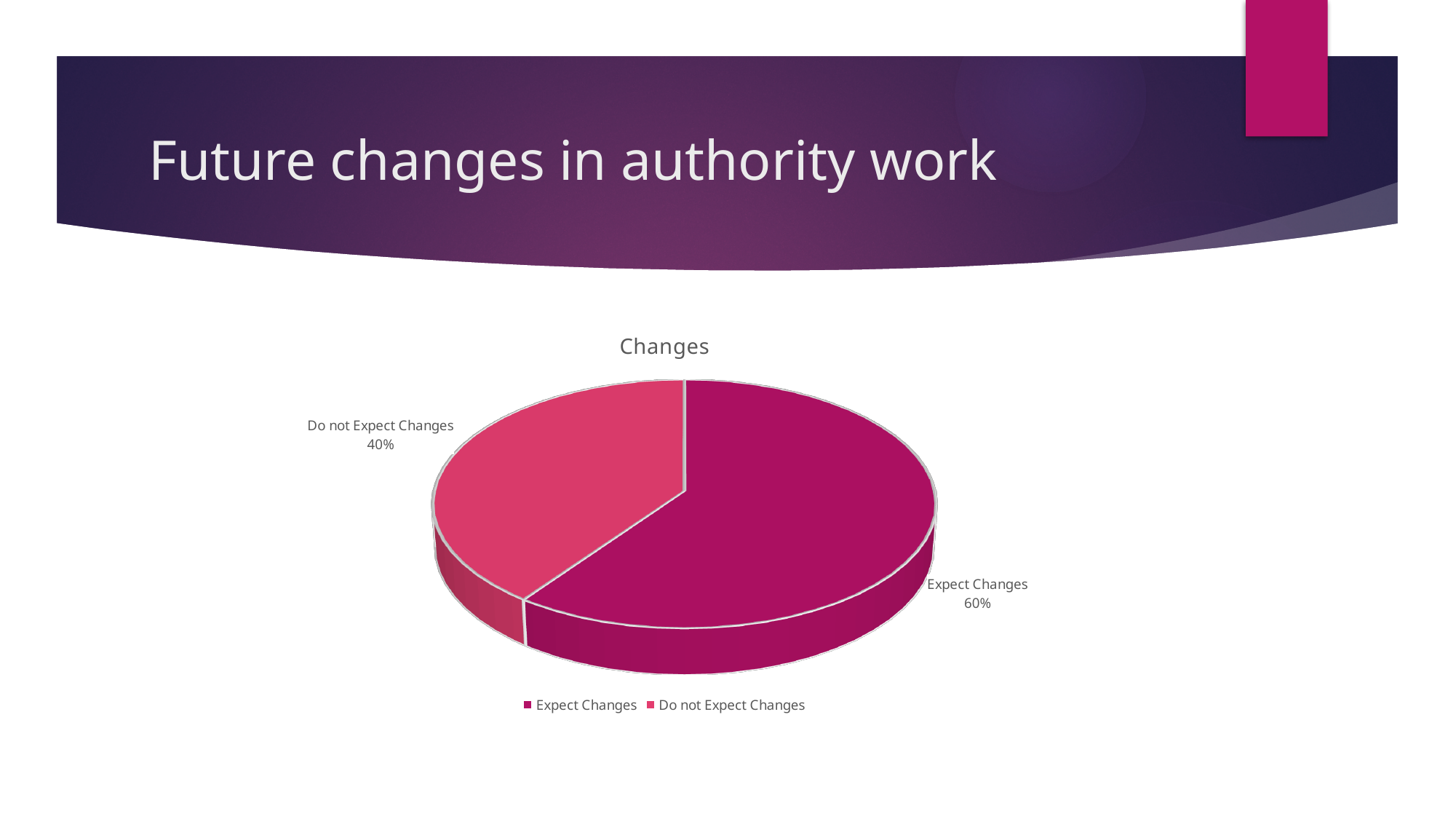
Which is larger, Expect Changes or Do not Expect Changes? Expect Changes Which slice of the pie is the largest? Expect Changes Is the share for Do not Expect Changes greater or less than 50%? less What kind of chart is shown on the slide? Pie chart What share of the pie does Do not Expect Changes represent? 40% How many slices does the pie chart have? 2 What is the difference in percentage points between Expect Changes and Do not Expect Changes? 20% How many entries does the legend list? 2 What is the title of the chart? Changes Which slice of the pie is the smallest? Do not Expect Changes What share of the pie does Expect Changes represent? 60%